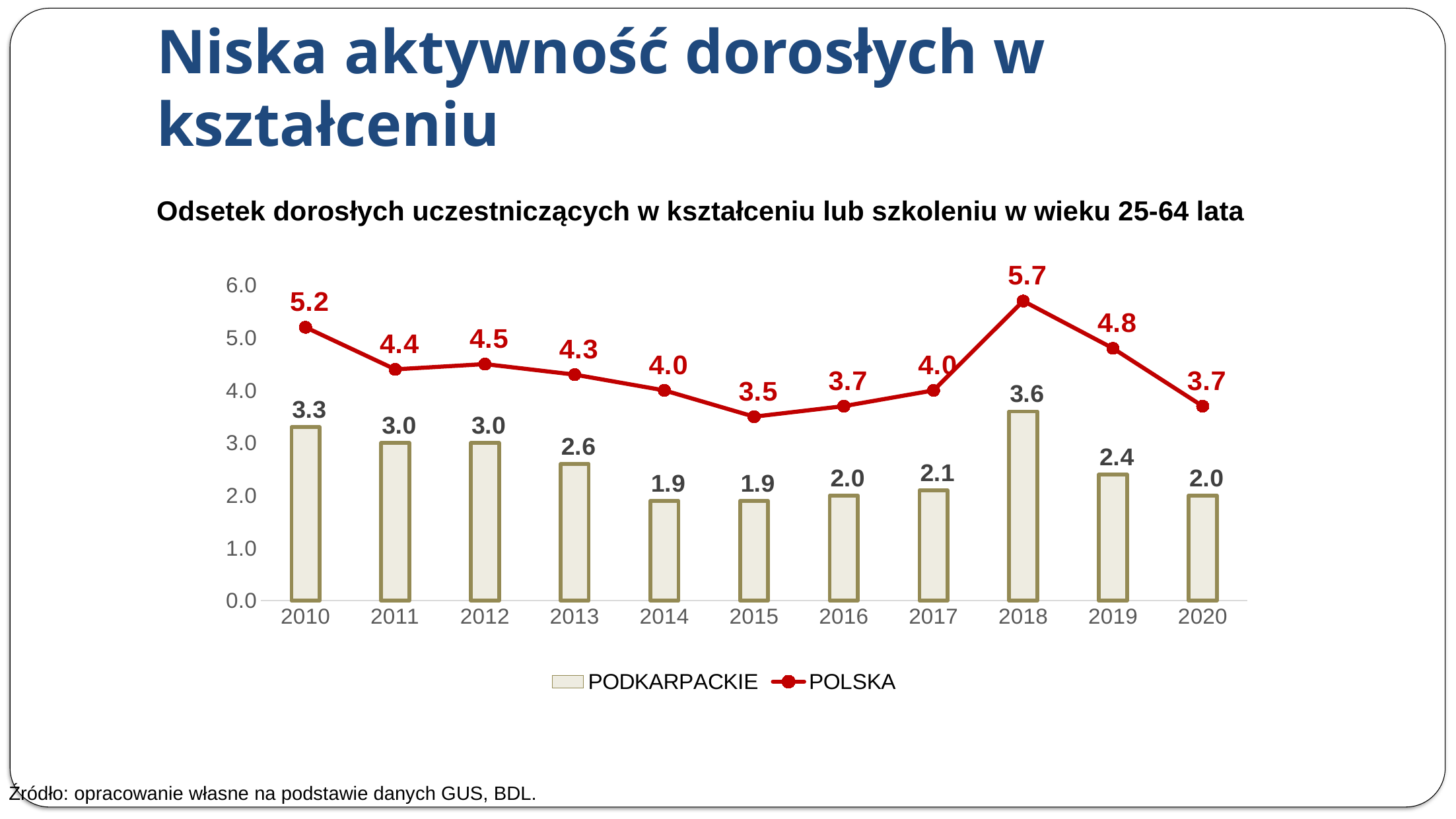
Which is larger in 2010: the PODKARPACKIE value or the POLSKA value? POLSKA Is the POLSKA value for 2019 greater or less than 4.0? greater In which year is the POLSKA value highest? 2018 Which series is drawn as a red line? POLSKA How many years are shown on the x axis? 11 What is the difference between the POLSKA and PODKARPACKIE values in 2018? 2.1 What is the value for PODKARPACKIE in 2013? 2.6 What kind of chart is shown on the slide? Combined bar and line chart Does the POLSKA value rise or fall from 2018 to 2020? fall In which year is the PODKARPACKIE value lowest? 2014 and 2015 What is the value for POLSKA in 2015? 3.5 How many series does the legend list? 2